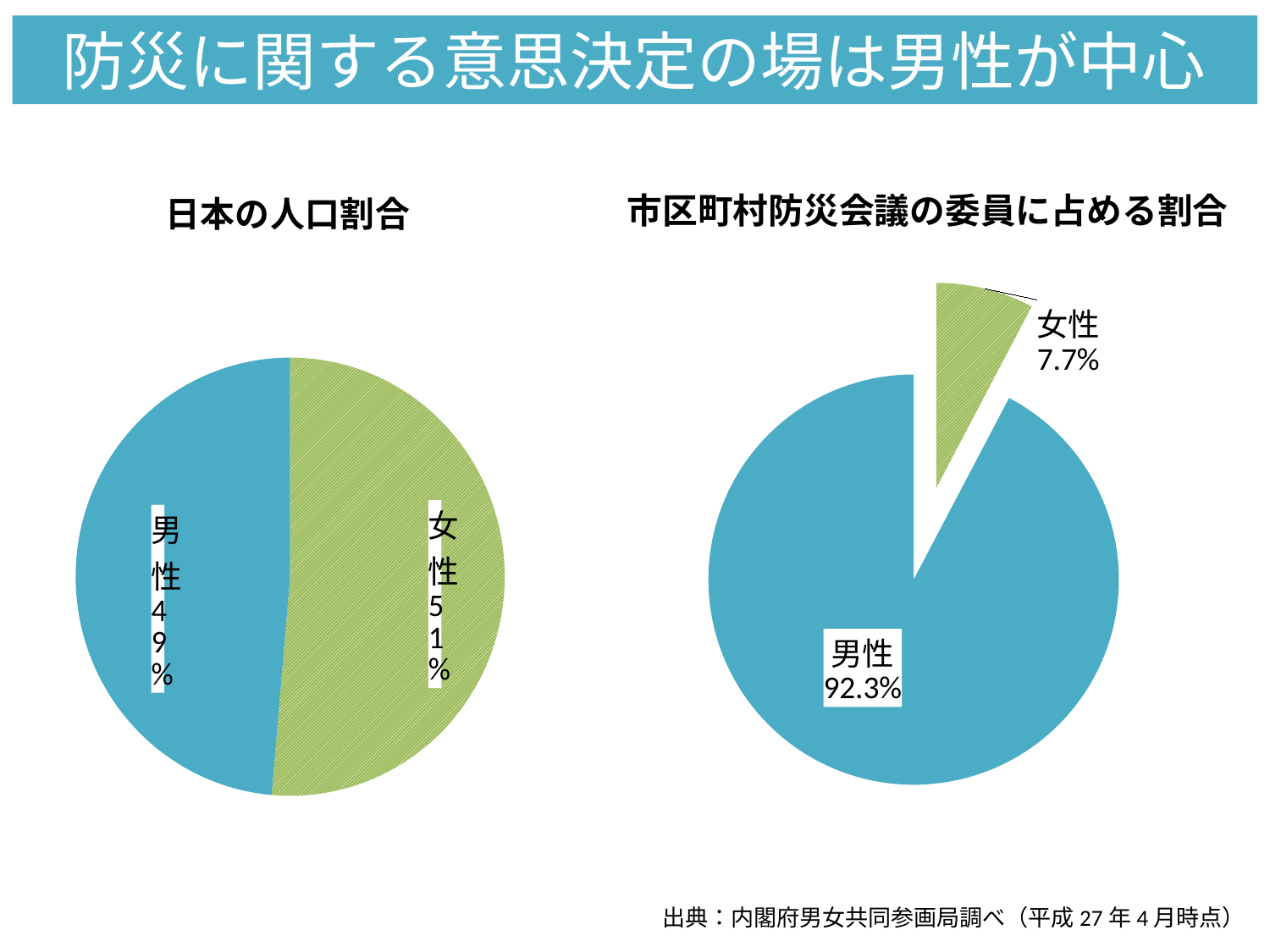
In the chart titled 日本の人口割合, what share is labelled for 男性? 49% What kind of chart is the chart titled 日本の人口割合? Pie chart In the chart titled 市区町村防災会議の委員に占める割合, what share is labelled for 男性? 92.3% How many slices does the chart titled 市区町村防災会議の委員に占める割合 have? 2 What is the title of the chart on the right side of the slide? 市区町村防災会議の委員に占める割合 In the chart titled 市区町村防災会議の委員に占める割合, which slice is the largest? 男性 In the chart titled 日本の人口割合, which is larger, 男性 or 女性? 女性 In the chart titled 日本の人口割合, what share is labelled for 女性? 51% In the chart titled 日本の人口割合, what is the difference between the 女性 and 男性 shares? 2% In the chart titled 市区町村防災会議の委員に占める割合, what share is labelled for 女性? 7.7% In the chart titled 市区町村防災会議の委員に占める割合, which slice is the smallest? 女性 In the chart titled 市区町村防災会議の委員に占める割合, what is the difference between the 男性 and 女性 shares? 84.6%